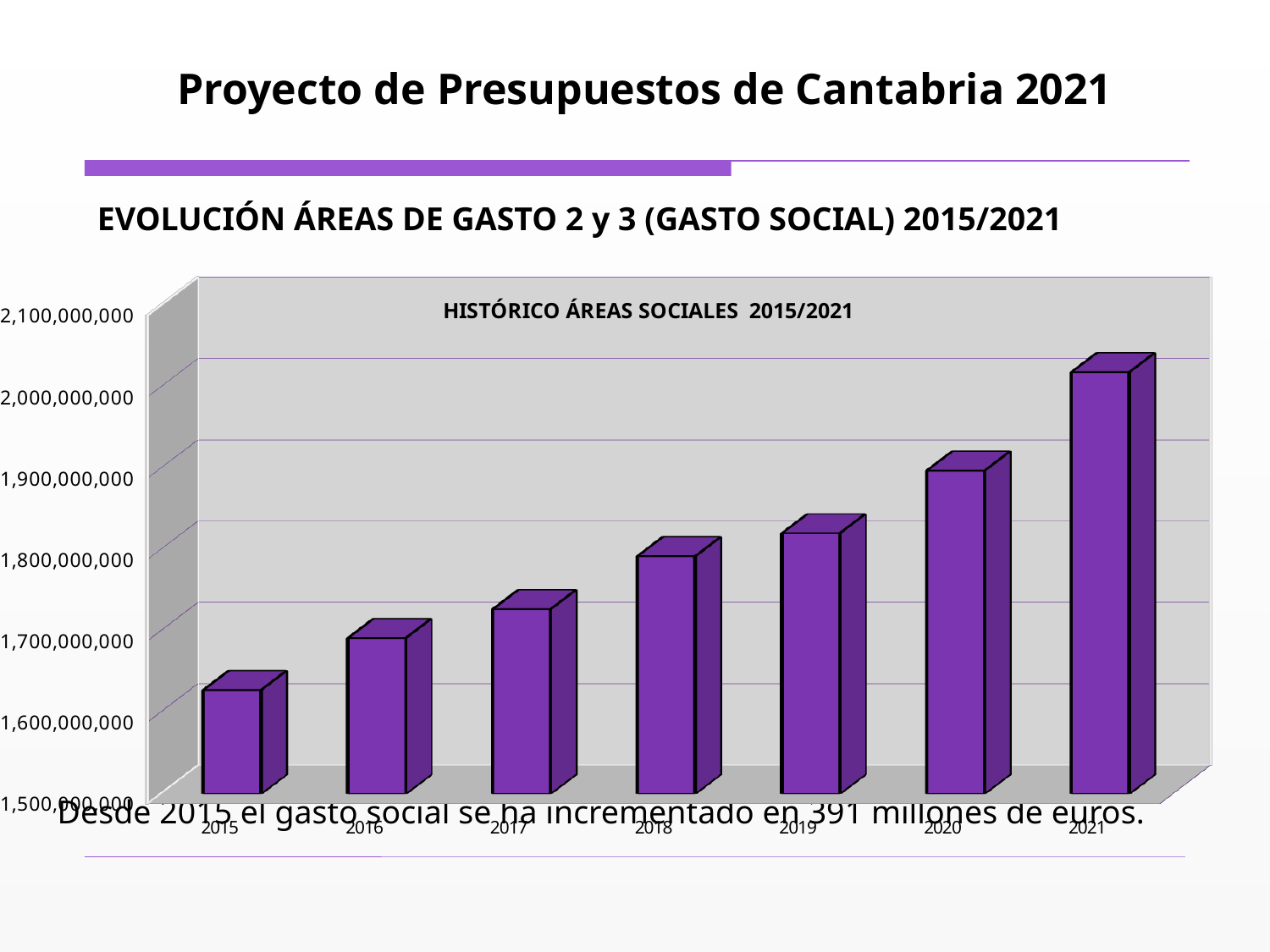
Is the value for 2019 greater or less than 1,800,000,000? greater What colour are the bars in the chart? Purple Which year has the highest value in the chart? 2021 Do the values rise or fall from 2015 to 2021? Rise Is the value for 2017 greater or less than 1,800,000,000? less How many years are plotted on the x axis of the chart? 7 Is the value for 2015 greater or less than 1,600,000,000? greater Which is larger, the value for 2021 or the value for 2015? 2021 What kind of chart is shown on the slide? Bar chart Which year has the lowest value in the chart? 2015 What is the title printed inside the chart area? HISTÓRICO ÁREAS SOCIALES 2015/2021